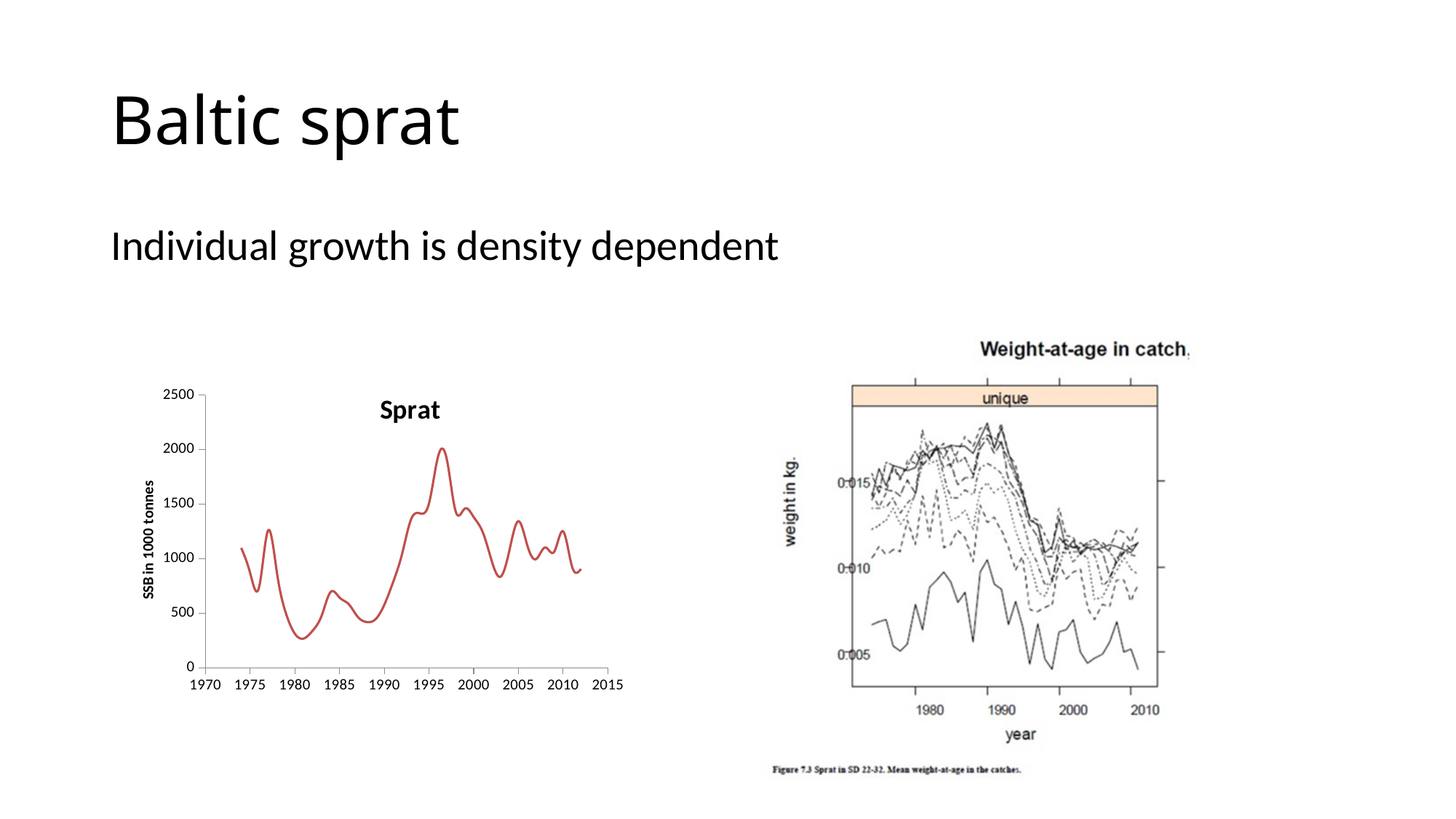
What is the title of the chart on the right of the slide? Weight-at-age in catch On the 'Sprat' chart, does the value rise or fall between 1990 and 1996? rise On the 'Sprat' chart, in roughly which year does the series reach its highest value: around 1996 or around 2005? around 1996 On the 'Sprat' chart, is the value around 1974 greater or less than 1000? greater On the 'Sprat' chart, is the value around 1981 greater or less than 500? less What kind of chart is the 'Sprat' chart on the left of the slide? line chart On the 'Sprat' chart, is the value around 1996 greater or less than 1500? greater On the 'Weight-at-age in catch' chart, do the upper group of lines rise or fall between 1990 and 2000? fall On the 'Weight-at-age in catch' chart, what is the label of the y axis? weight in kg On the 'Sprat' chart, does the value rise or fall between 1977 and 1981? fall On the 'Sprat' chart, what is the label of the y axis? SSB in 1000 tonnes